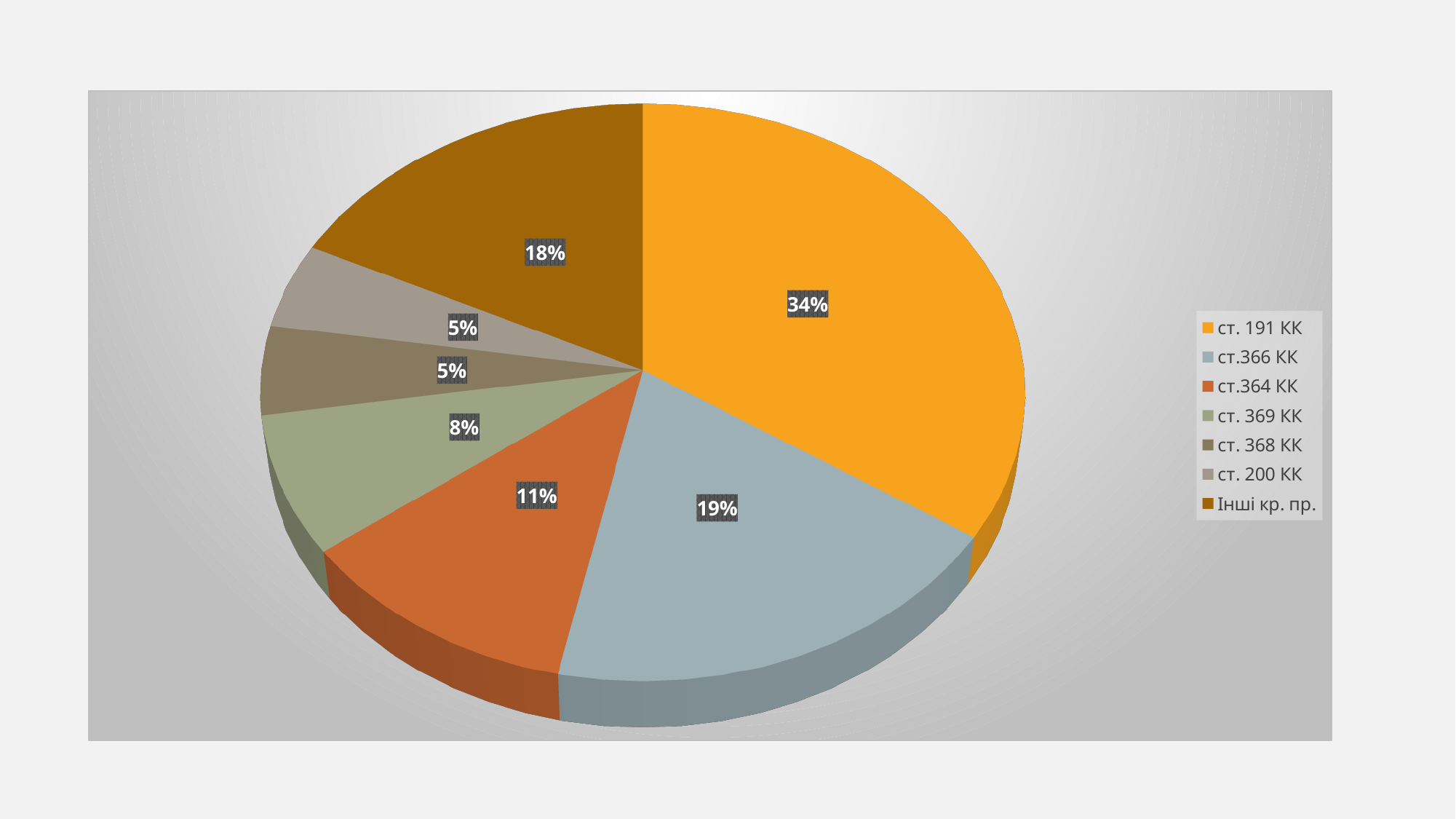
What colour is the slice for ст. 191 КК? orange Which category has the largest slice of the pie? ст. 191 КК What share of the pie does ст.364 КК have? 11% What is the difference in percentage points between ст. 191 КК and ст.366 КК? 15 How many slices does the pie chart have? 7 Which is larger, the slice for ст.364 КК or the slice for Інші кр. пр.? Інші кр. пр. What share of the pie does ст. 191 КК have? 34% What share of the pie does ст. 369 КК have? 8% What kind of chart is shown on the slide? pie chart How many entries does the legend list? 7